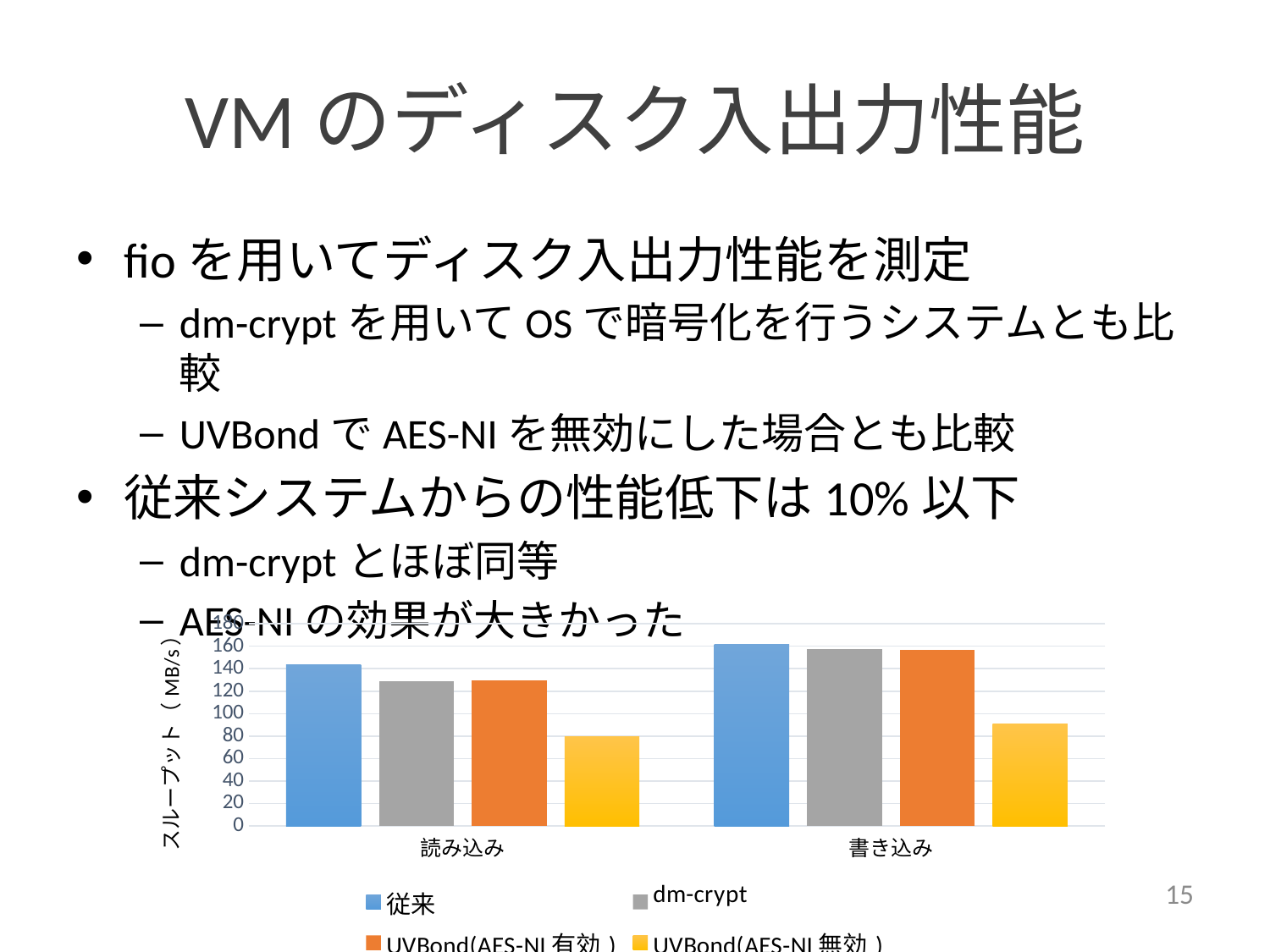
For the 従来 series, which is larger: the value for 読み込み or the value for 書き込み? 書き込み Is the value for 従来 in 書き込み greater or less than 140? greater Which series has the lowest value for 書き込み? UVBond(AES-NI 無効) How many series does the chart's legend list? 4 Is the value for UVBond(AES-NI 無効) in 読み込み greater or less than 100? less Which series has the highest value for 読み込み? 従来 Which series has the lowest value for 読み込み? UVBond(AES-NI 無効) How many categories are shown on the x axis of the chart? 2 Is the value for dm-crypt in 読み込み greater or less than 100? greater What is the label of the chart's vertical axis? スループット（MB/s） What kind of chart is shown on the slide? bar chart Which series is shown in yellow in the chart? UVBond(AES-NI 無効)